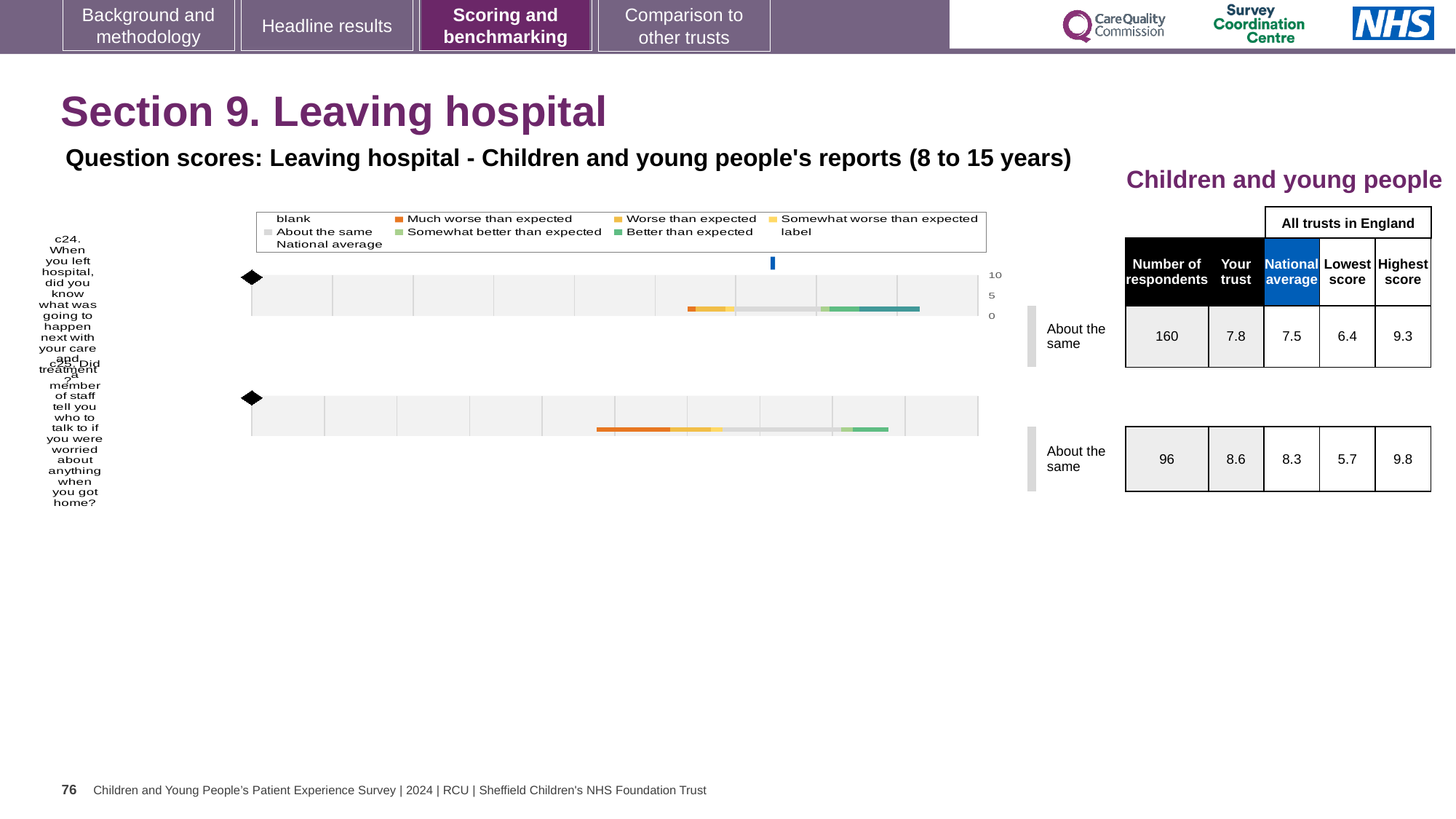
What is the 'Your trust' score for question c25 (Did a member of staff tell you who to talk to if you were worried about anything when you got home?)? 8.6 Which question has the higher 'Your trust' score, c24 or c25? c25 What benchmarking category is shown for question c24? About the same What is the 'Your trust' score for question c24 (When you left hospital, did you know what was going to happen next with your care and treatment?)? 7.8 What is the highest score among all trusts in England for question c25? 9.8 What is the difference between the highest and lowest scores for question c25? 4.1 How many survey questions are plotted in the chart? 2 What is the difference between the 'Your trust' score and the national average for question c24? 0.3 What is the lowest score among all trusts in England for question c24? 6.4 What kind of chart is shown on the slide? bar chart What is the number of respondents for question c25? 96 What is the national average score for question c24? 7.5